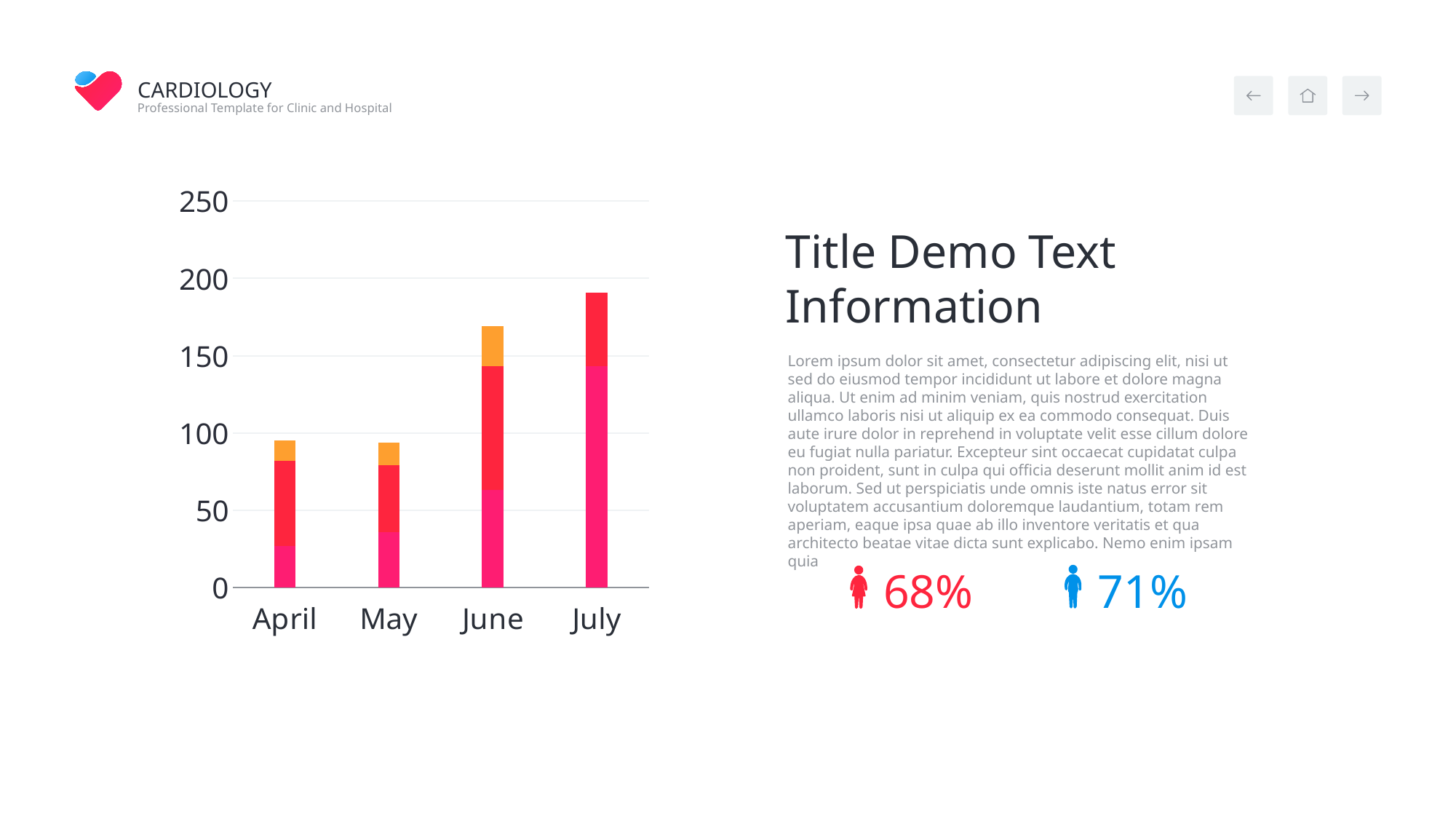
Is the total bar height for June greater or less than 150? greater Do the bar totals rise or fall from May to July? rise Is the total bar height for July greater or less than 200? less Is the total bar height for May greater or less than 150? less What kind of chart is shown on the slide? bar chart Which bar is taller, April or June? June Which month has the tallest bar in the chart? July Which bar is taller, June or July? July How many months are shown on the x axis of the chart? 4